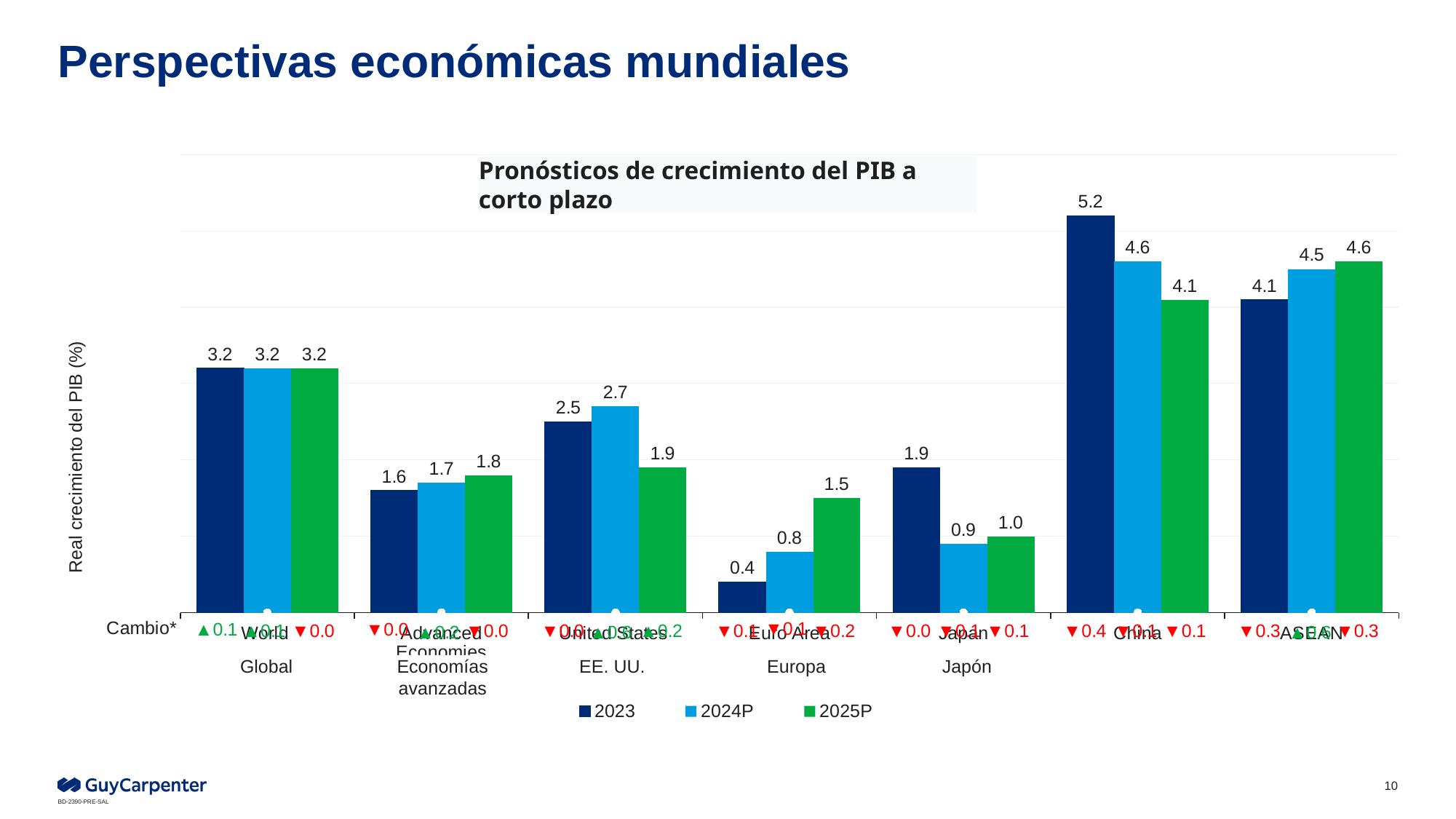
Which category has the lowest 2024P value? Europa (Euro Area) Which is larger: the 2025P value for ASEAN or the 2025P value for China? ASEAN What kind of chart is shown on the slide? Bar chart Which category has the highest 2023 value? China How many categories are shown on the x axis? 7 Do the values for Europa (Euro Area) rise or fall from 2023 to 2025P? Rise What is the 2023 value for China in the chart? 5.2 What is the 2025P value for Europa (Euro Area)? 1.5 What is the difference between the 2023 and 2025P values for China? 1.1 What is the 2024P value for EE. UU. (United States)? 2.7 How many series does the legend list? 3 What is the title of the chart? Pronósticos de crecimiento del PIB a corto plazo